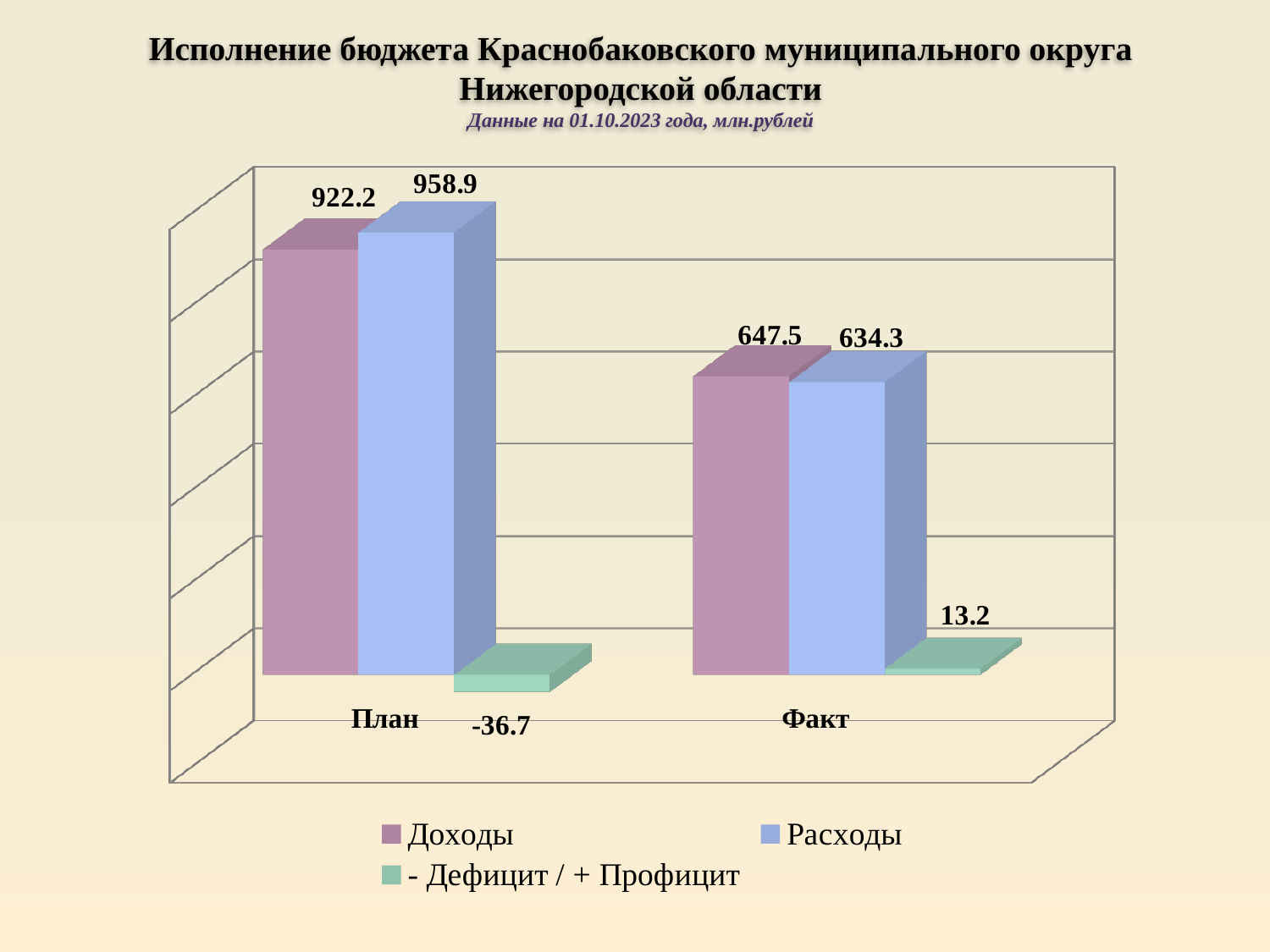
How many series does the legend list? 3 What is the value of Расходы for План? 958.9 What kind of chart is shown on the slide? Bar chart How many categories are shown on the x axis? 2 What is the value of Доходы for План? 922.2 What is the value of - Дефицит / + Профицит for План? -36.7 What is the value of - Дефицит / + Профицит for Факт? 13.2 What is the difference between Расходы and Доходы for План? 36.7 Which category has the higher value for Расходы, План or Факт? План What is the value of Доходы for Факт? 647.5 What is the value of Расходы for Факт? 634.3 What is the difference between Доходы for План and Доходы for Факт? 274.7